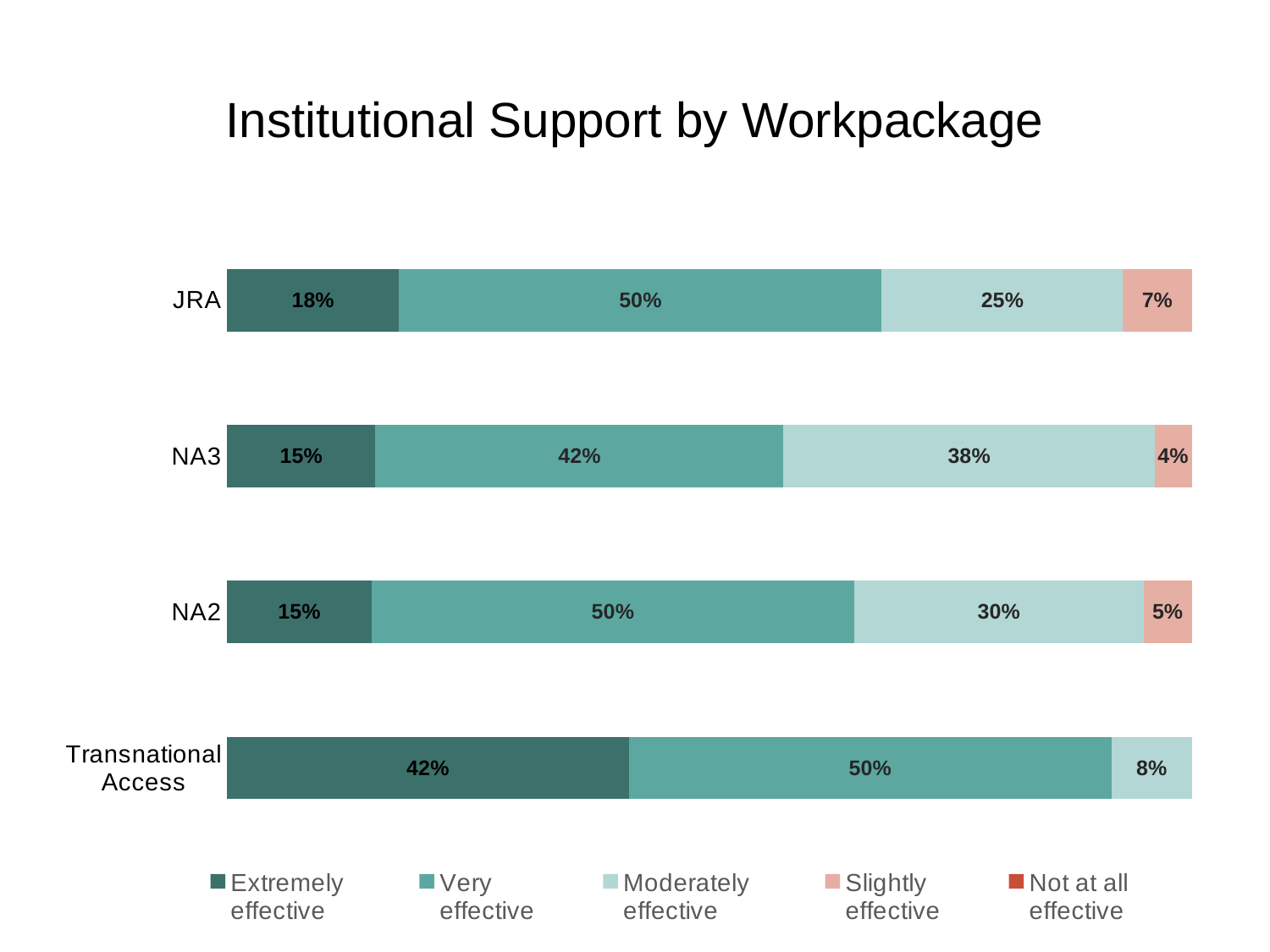
What is the title of the chart? Institutional Support by Workpackage What percentage of JRA respondents rated institutional support as Extremely effective? 18% What is the difference between the Extremely effective shares of Transnational Access and JRA? 24% What percentage of NA3 respondents rated institutional support as Moderately effective? 38% Which workpackage has the highest Extremely effective share? Transnational Access What is the Slightly effective value for NA2? 5% Which is larger: the Moderately effective share for NA3 or for NA2? NA3 How many series does the legend list? 5 What percentage of Transnational Access respondents rated institutional support as Very effective? 50% How many workpackages are shown on the chart? 4 What kind of chart is shown on the slide? Stacked bar chart Which workpackage has the lowest Moderately effective share? Transnational Access